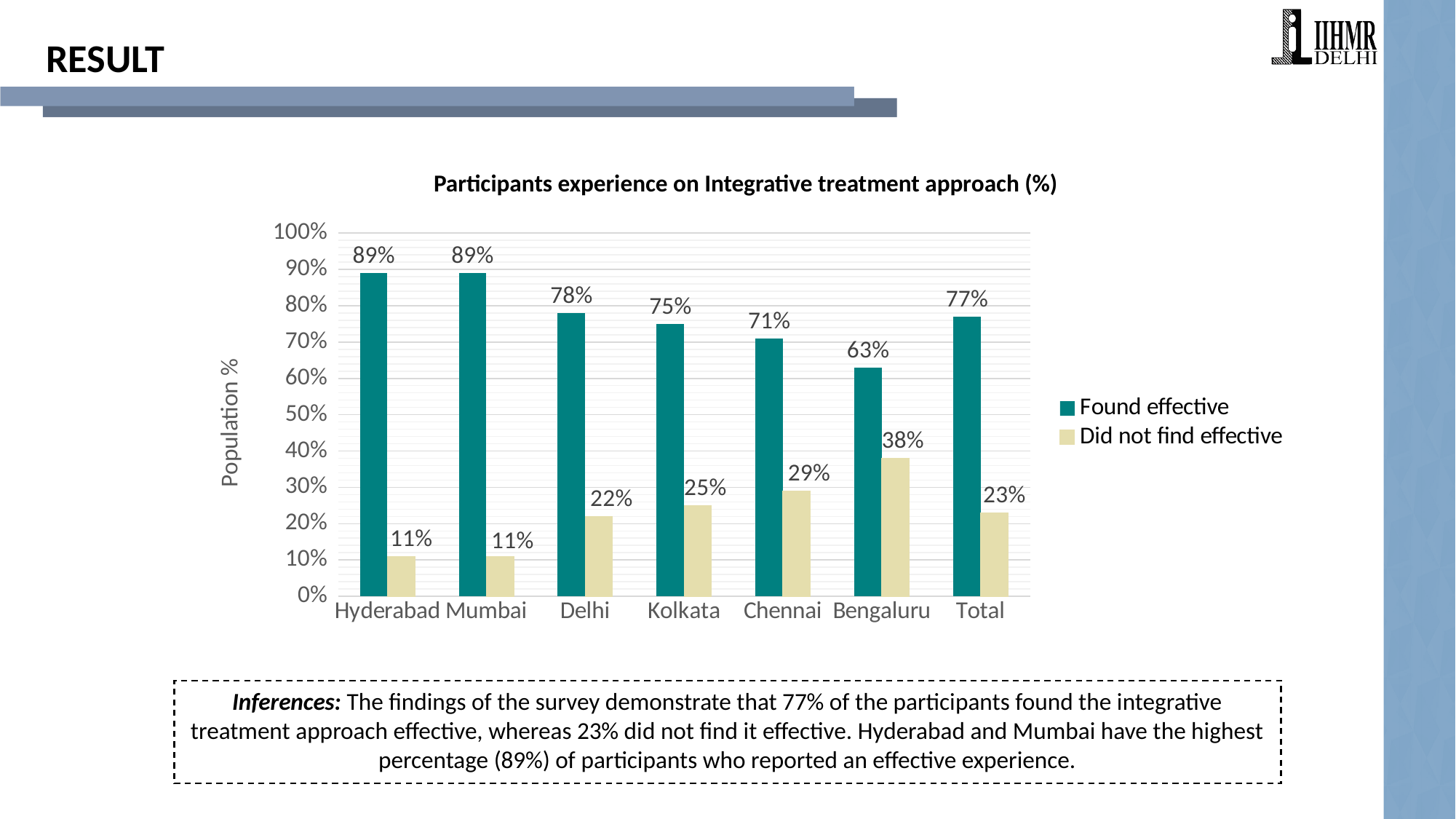
How many series does the legend list? 2 Is the 'Found effective' value for Chennai greater or less than 80%? less What is the title of the chart? Participants experience on Integrative treatment approach (%) What percentage of participants in Delhi found the integrative treatment approach effective? 78% Which is larger: the 'Did not find effective' value for Delhi or for Kolkata? Kolkata Which city has the highest 'Did not find effective' percentage? Bengaluru What is the 'Found effective' value for the Total category? 77% How many categories are shown on the x axis? 7 Which city has the lowest 'Found effective' percentage? Bengaluru What is the difference between the 'Found effective' values for Kolkata and Chennai? 4% What kind of chart is shown on the slide? Bar chart What is the 'Did not find effective' value for Bengaluru? 38%